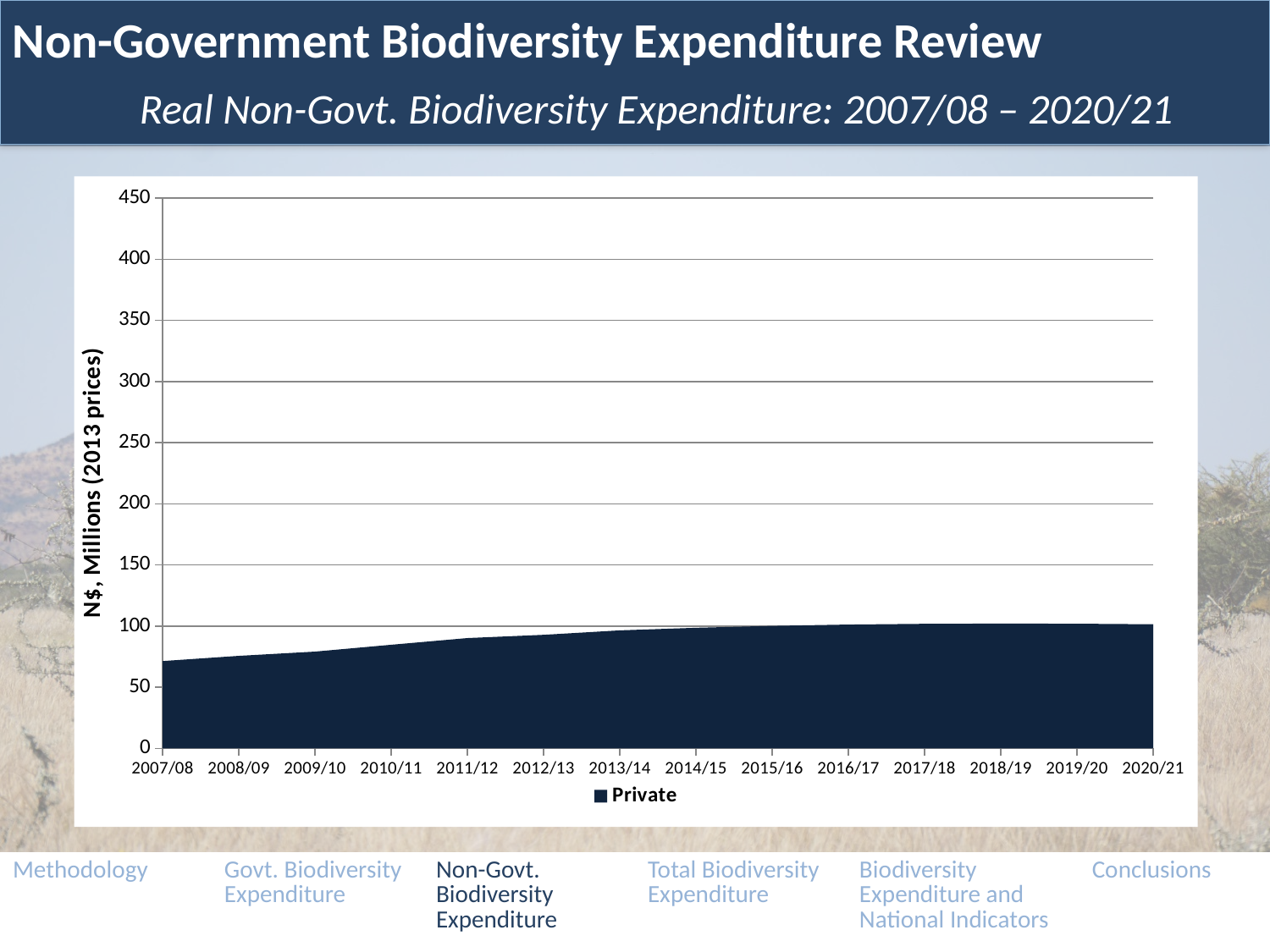
What kind of chart is shown on the slide? Area chart Is the value for Private in 2020/21 greater or less than 150? less What is the label on the y axis? N$, Millions (2013 prices) Do the Private values generally rise or fall from 2007/08 to 2020/21? Rise Which year has the lowest value for Private? 2007/08 How many years are shown along the x axis? 14 Is the value for Private in 2007/08 greater or less than 100? less What is the name of the series shown in the legend? Private Which is larger, the Private value in 2007/08 or in 2020/21? 2020/21 Is the value for Private in 2010/11 greater or less than 100? less How many series does the legend list? 1